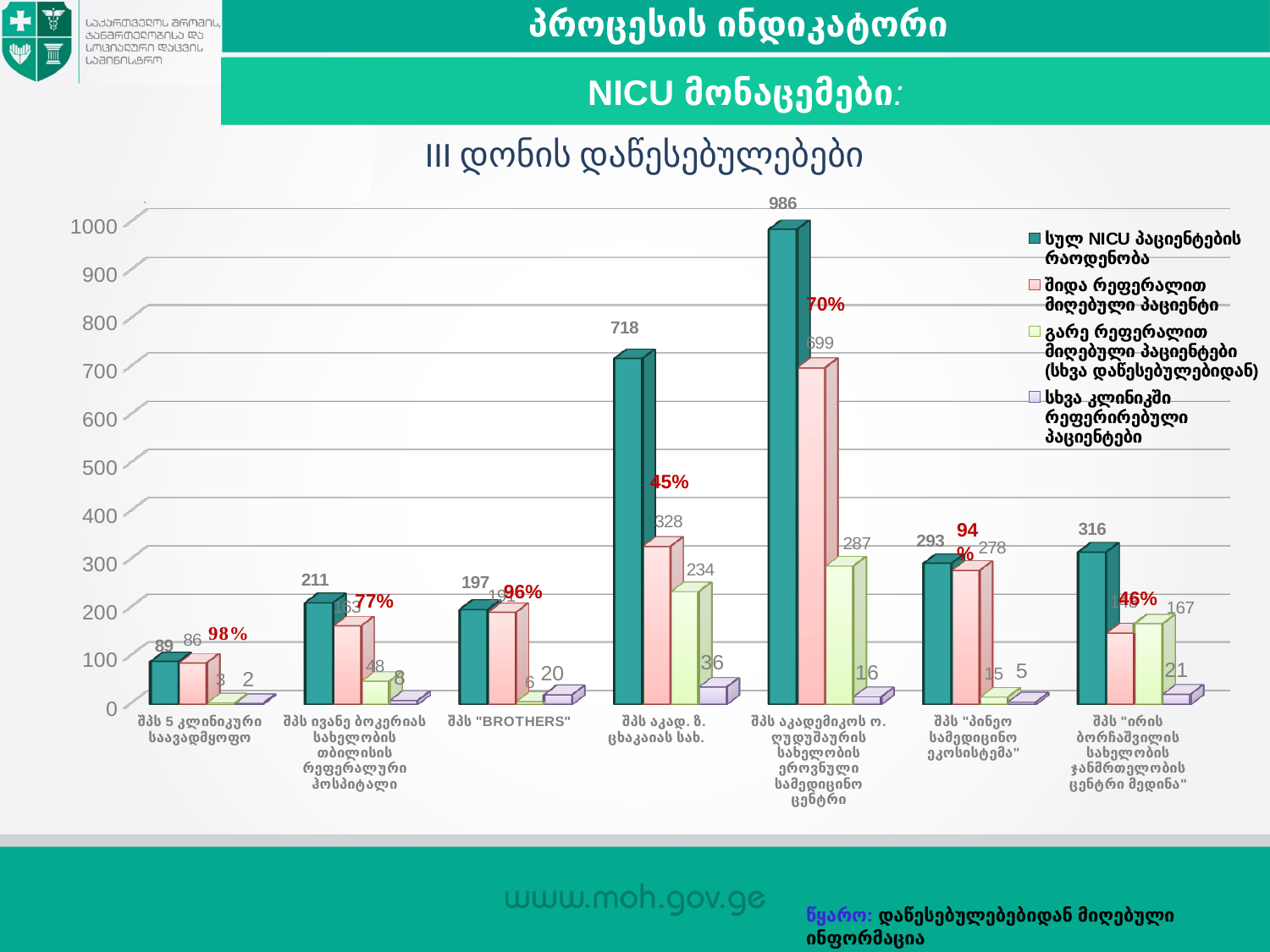
Which hospital has the lowest value for the total NICU patients series (სულ NICU პაციენტების რაოდენობა)? შპს 5 კლინიკური საავადმყოფო What is the total NICU patients value for შპს "BROTHERS"? 197 How many series does the chart legend list? 4 What is the title shown directly above the chart? III დონის დაწესებულებები What is the difference between the total NICU patients values for შპს აკადემიკოს ო. ღუდუშაურის სახელობის ეროვნული სამედიცინო ცენტრი (986) and შპს აკად. ზ. ცხაკაიას სახ. (718)? 268 How many hospitals (categories) are shown on the x axis of the chart? 7 What type of chart is shown on the slide? bar chart What is the total NICU patients value for შპს "პინეო სამედიცინო ეკოსისტემა"? 293 Which hospital has the highest value for the total NICU patients series (სულ NICU პაციენტების რაოდენობა)? შპს აკადემიკოს ო. ღუდუშაურის სახელობის ეროვნული სამედიცინო ცენტრი What percentage label is shown above the bars for შპს 5 კლინიკური საავადმყოფო? 98% Which has a larger total NICU patients value: შპს აკად. ზ. ცხაკაიას სახ. or შპს "ირის ბორჩაშვილის სახელობის ჯანმრთელობის ცენტრი მედინა"? შპს აკად. ზ. ცხაკაიას სახ. What is the value of the external referral series (გარე რეფერალით მიღებული პაციენტები) for შპს აკადემიკოს ო. ღუდუშაურის სახელობის ეროვნული სამედიცინო ცენტრი? 287